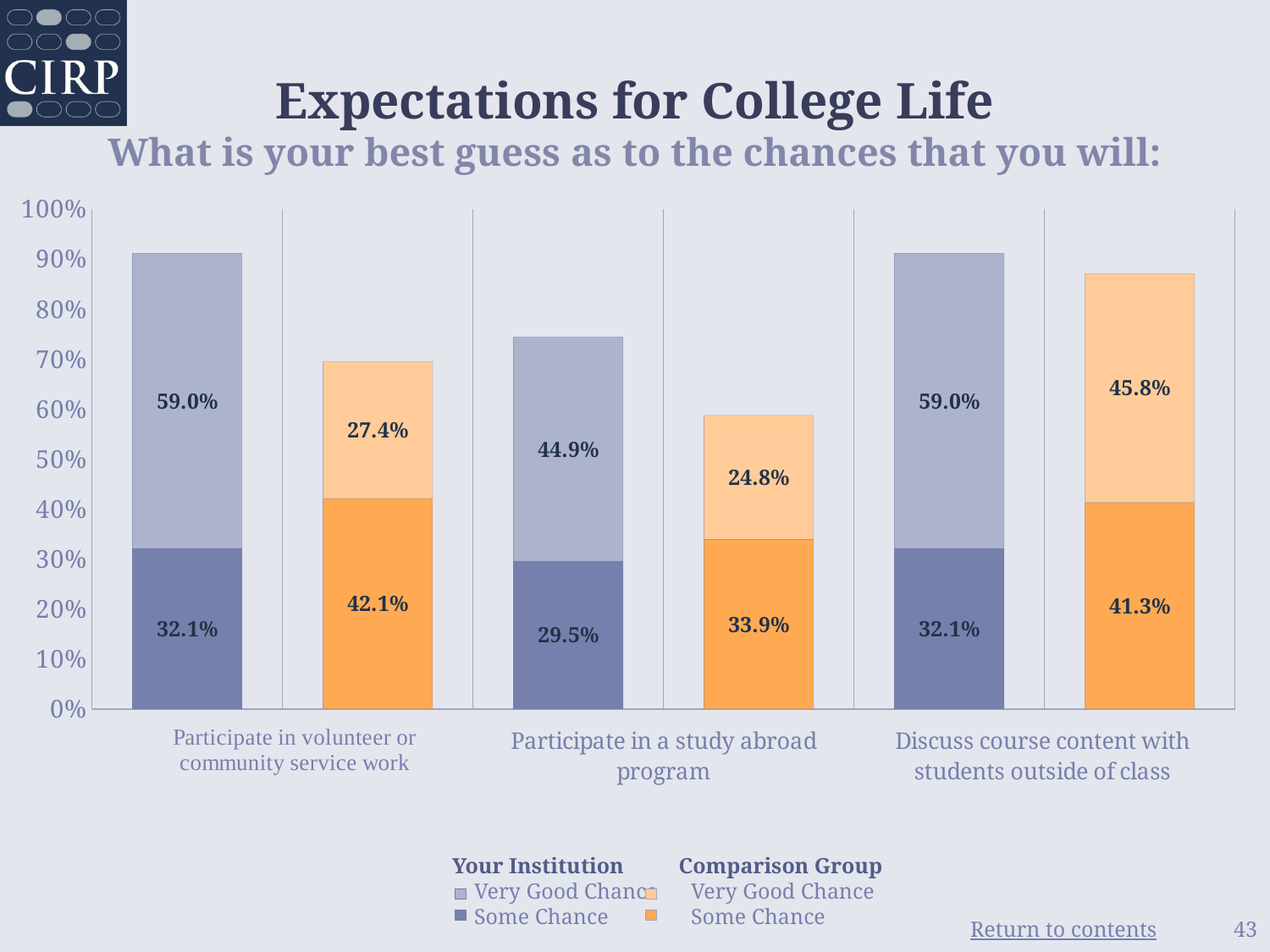
How many categories are shown along the x axis? 3 How many series does the legend list? 4 For 'Discuss course content with students outside of class', which is larger: the Your Institution 'Very Good Chance' value or the Comparison Group 'Very Good Chance' value? Your Institution Which category has the lowest Your Institution 'Some Chance' value? Participate in a study abroad program What is the Comparison Group 'Some Chance' value for 'Discuss course content with students outside of class'? 41.3% What is the Your Institution 'Very Good Chance' value for 'Participate in a study abroad program'? 44.9% What kind of chart is shown on the slide? Stacked bar chart What is the difference between the Your Institution and Comparison Group 'Very Good Chance' values for 'Participate in volunteer or community service work'? 31.6% Which category has the highest Comparison Group 'Very Good Chance' value? Discuss course content with students outside of class What is the subtitle question shown above the chart? What is your best guess as to the chances that you will: What is the Comparison Group 'Very Good Chance' value for 'Participate in volunteer or community service work'? 27.4% What is the total of the Comparison Group stacked bar for 'Participate in a study abroad program'? 58.7%